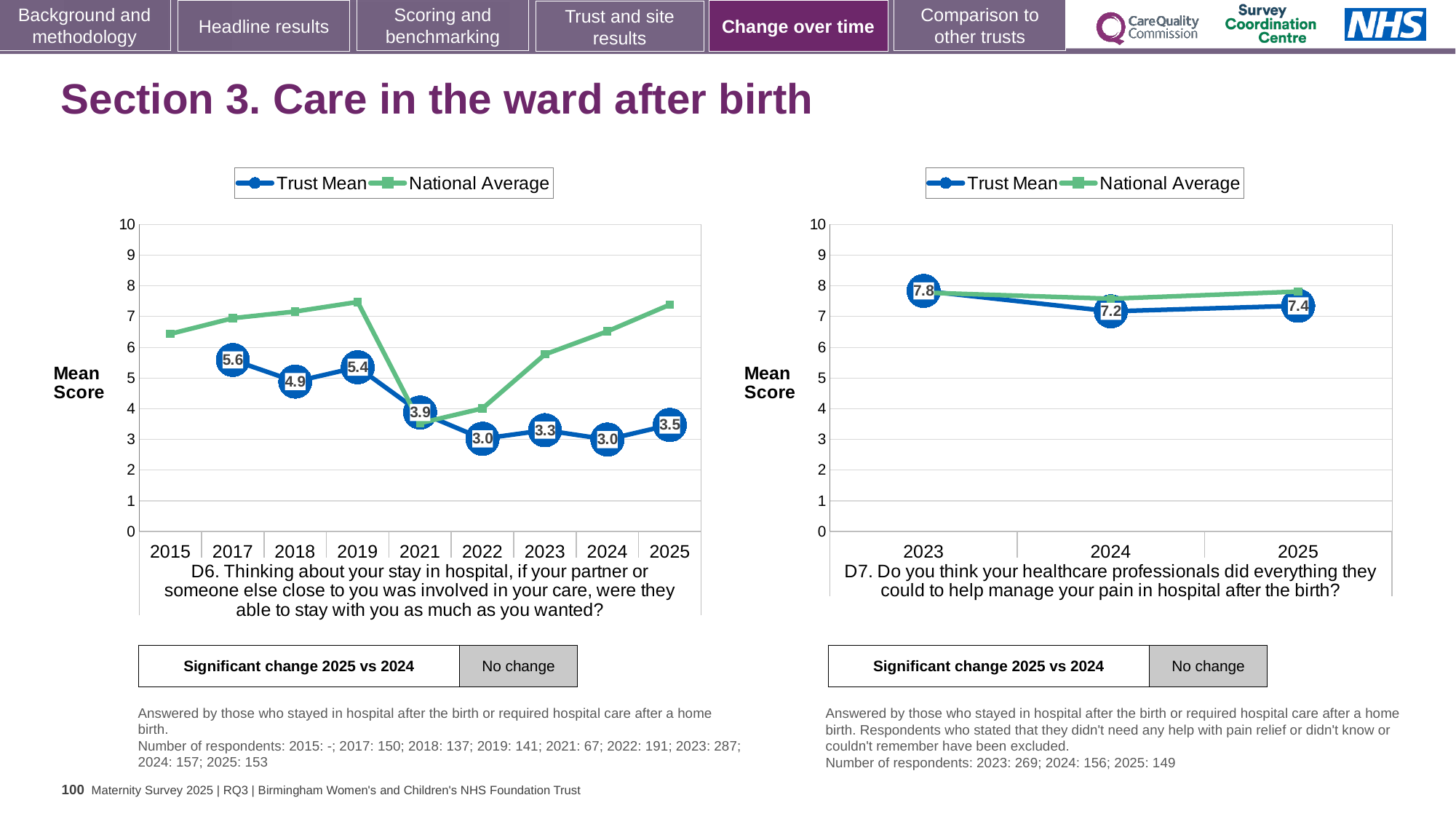
In the D7 chart on the right, what is the Trust Mean score for 2024? 7.2 In the D7 chart on the right, which year has the lowest Trust Mean score? 2024 In the D6 chart on the left, which year has the highest Trust Mean score? 2017 In the D6 chart on the left, what is the Trust Mean score for 2017? 5.6 What type of chart is the D6 chart on the left? Line chart How many series does the legend of the D7 chart on the right list? 2 In the D6 chart on the left, what is the difference between the Trust Mean scores for 2019 and 2021? 1.5 In the D6 chart on the left, what is the Trust Mean score for 2025? 3.5 In the D7 chart on the right, what is the difference between the Trust Mean scores for 2023 and 2025? 0.4 In the D6 chart on the left, is the National Average for 2025 greater or less than 7? greater In the D6 chart on the left, how many years are shown on the x axis? 9 In the D7 chart on the right, is the Trust Mean for 2023 larger or smaller than the Trust Mean for 2025? larger